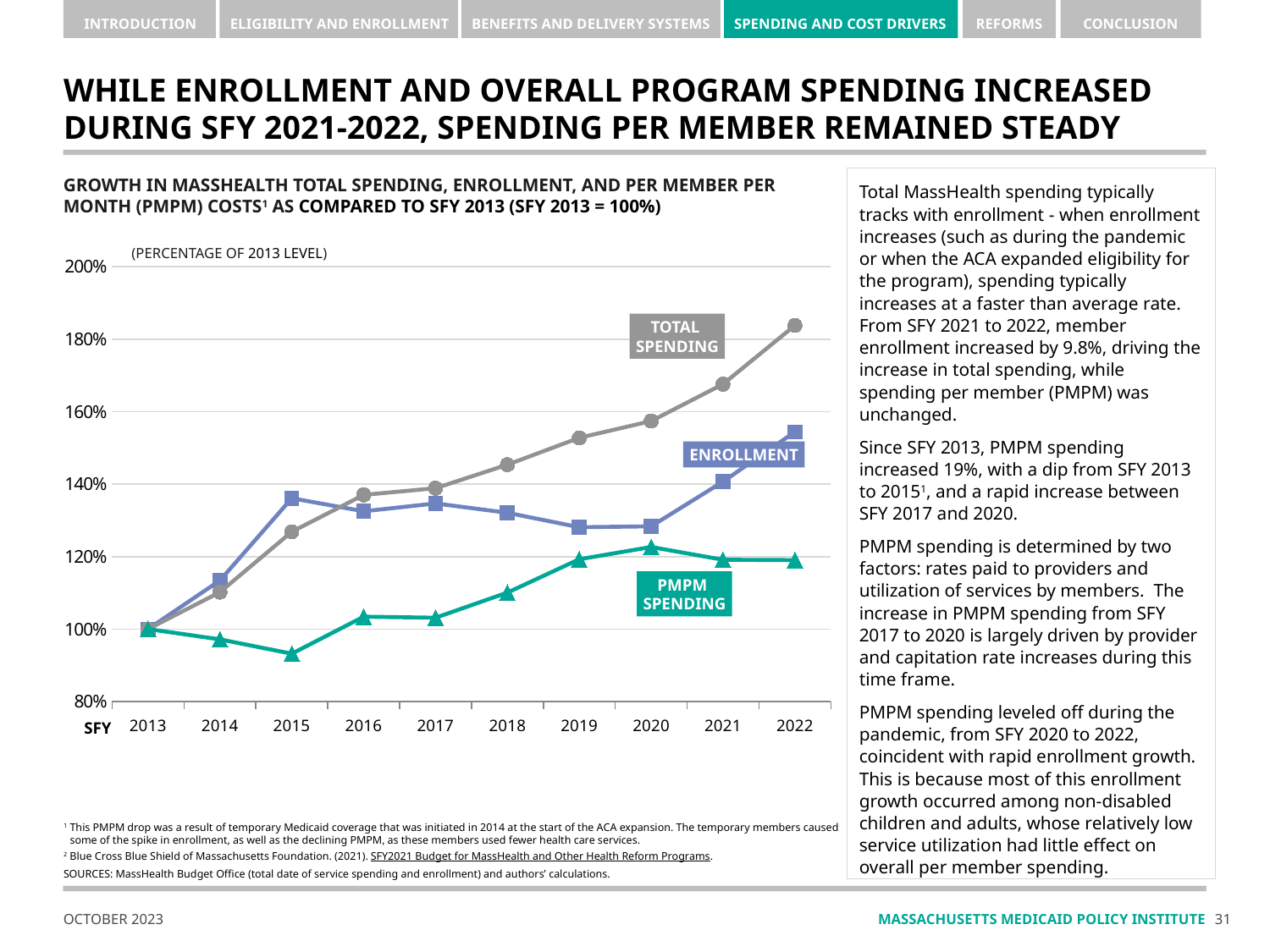
Does Total Spending rise or fall from SFY 2013 to SFY 2022? rise Is the value for Total Spending in SFY 2022 greater or less than 180%? greater In SFY 2015, which is higher: Enrollment or Total Spending? Enrollment How many series are plotted in the chart? 3 What kind of chart is shown on the slide? line chart Which series has the highest value in SFY 2022? Total Spending What is the value of Total Spending in SFY 2013? 100% Which series has the lowest value in SFY 2022? PMPM Spending Is the value for Enrollment in SFY 2015 greater or less than 140%? less How many fiscal years are plotted along the x axis of the chart? 10 Is the value for Enrollment in SFY 2022 greater or less than 140%? greater